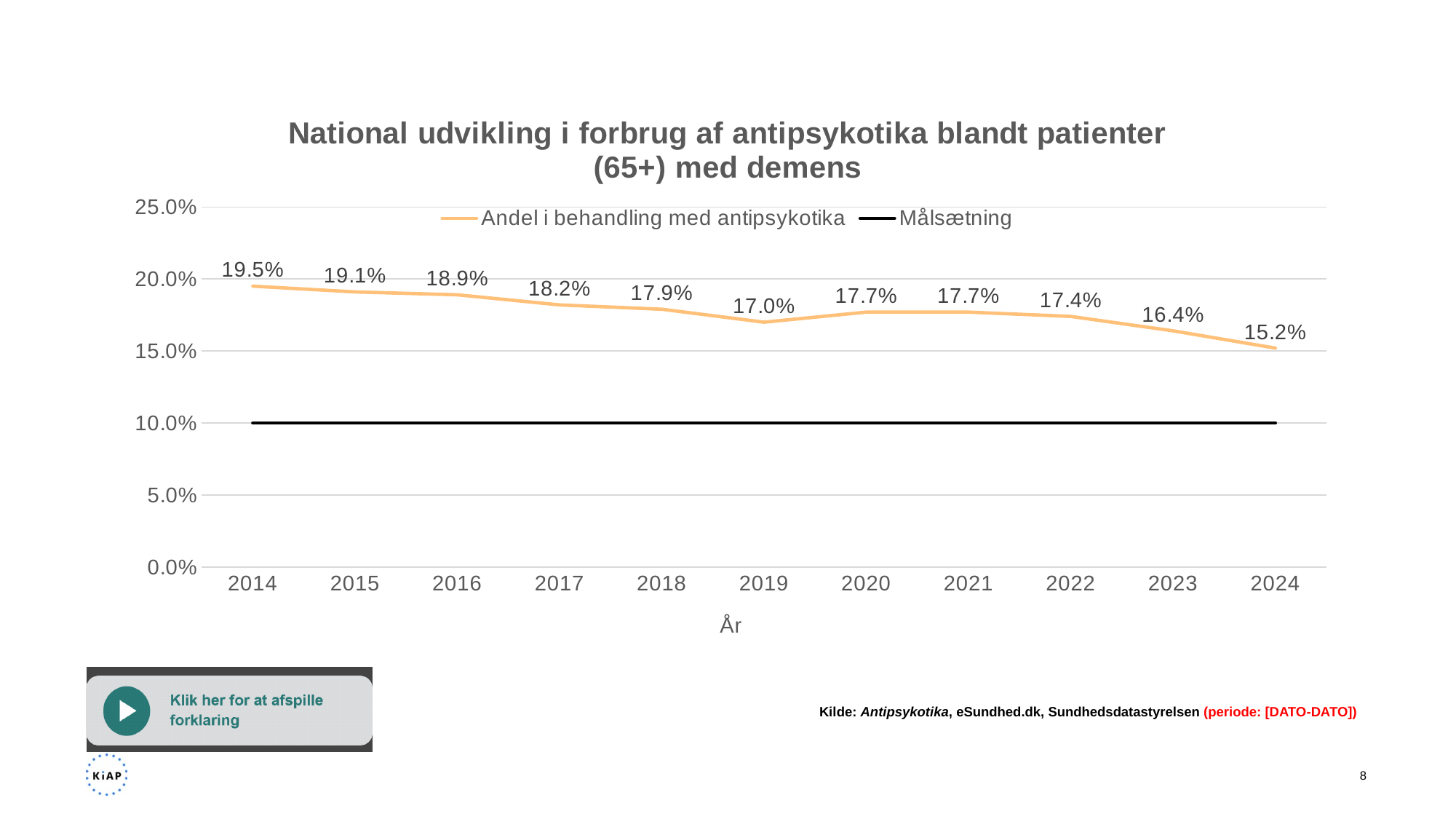
What is the difference between the 'Andel i behandling med antipsykotika' values for 2014 and 2024? 4.3% What is the value of 'Andel i behandling med antipsykotika' for 2019? 17.0% Is the 'Målsætning' line greater or less than 15.0%? less Does the 'Andel i behandling med antipsykotika' line generally rise or fall from 2014 to 2024? fall What is the value of 'Andel i behandling med antipsykotika' for 2024? 15.2% How many series does the legend list? 2 How many years are shown on the x axis? 11 Which year has the highest value for 'Andel i behandling med antipsykotika'? 2014 Which is larger, the 'Andel i behandling med antipsykotika' value for 2018 or for 2019? 2018 Which year has the lowest value for 'Andel i behandling med antipsykotika'? 2024 What kind of chart is shown on the slide? line chart What is the value of 'Andel i behandling med antipsykotika' for 2014? 19.5%